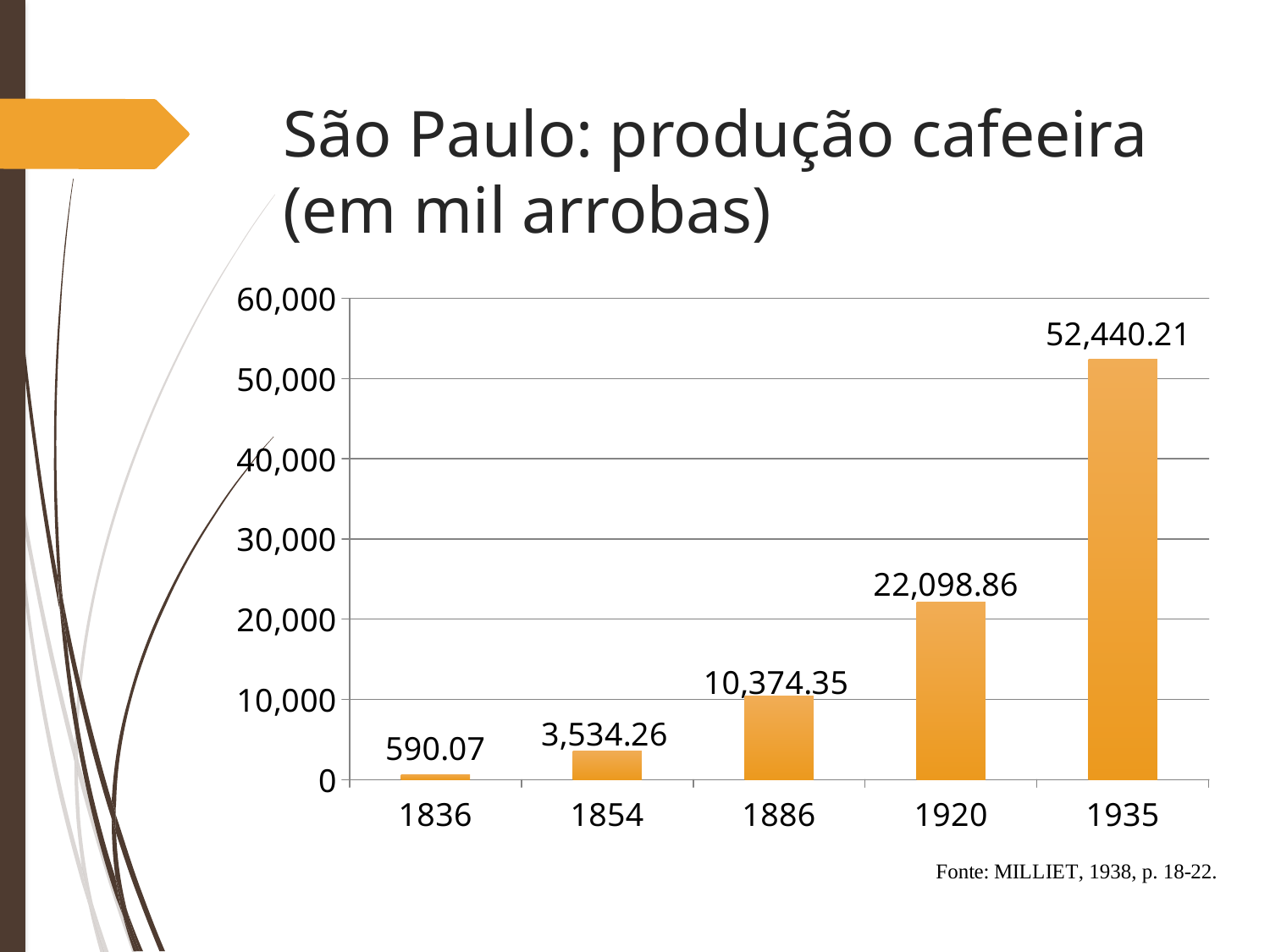
Do the values rise or fall from 1836 to 1935? rise What is the coffee production value shown for 1920? 22,098.86 What is the difference between the values for 1854 and 1836? 2,944.19 What is the value shown for 1886? 10,374.35 Which year has the lowest coffee production? 1836 How many years are shown on the x axis? 5 Which year has the highest coffee production? 1935 What kind of chart is shown on the slide? bar chart What is the difference between the values for 1935 and 1920? 30,341.35 What is the value shown for 1836? 590.07 Is the value for 1935 greater or less than 50,000? greater Which year has a larger value, 1886 or 1854? 1886